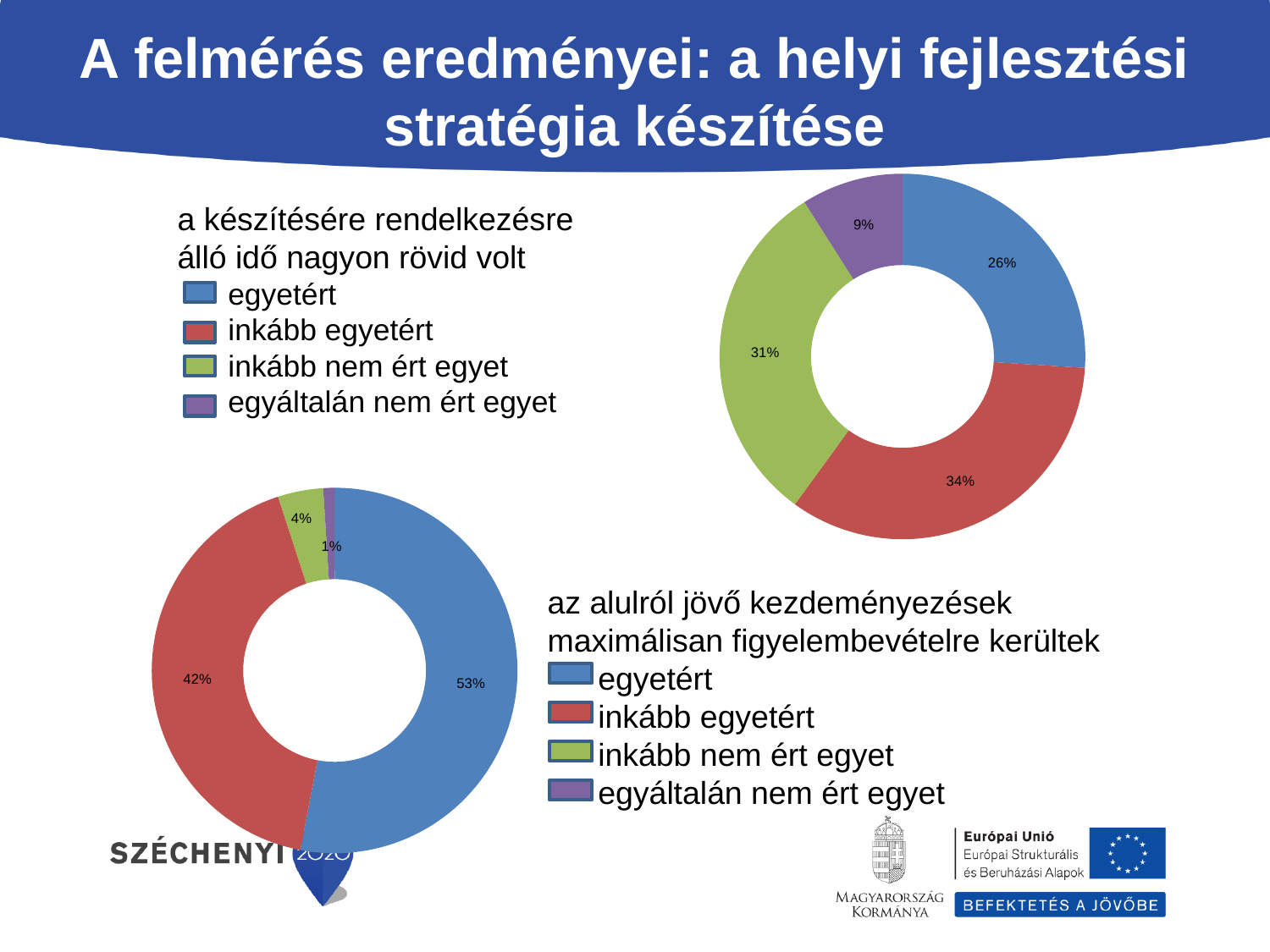
In the top-right chart (a készítésére rendelkezésre álló idő nagyon rövid volt), what share of respondents chose 'egyáltalán nem ért egyet'? 9% How many response categories does the legend of the top-right chart list? 4 In the top-right chart (a készítésére rendelkezésre álló idő nagyon rövid volt), what share of respondents chose 'inkább egyetért'? 34% What type of chart is used on this slide? Doughnut (pie) chart In the top-right chart (a készítésére rendelkezésre álló idő nagyon rövid volt), which response category has the smallest share? egyáltalán nem ért egyet In the bottom-left chart (az alulról jövő kezdeményezések maximálisan figyelembevételre kerültek), which is larger: 'egyetért' or 'inkább egyetért'? egyetért In the top-right chart (a készítésére rendelkezésre álló idő nagyon rövid volt), which response category has the largest share? inkább egyetért In the bottom-left chart (az alulról jövő kezdeményezések maximálisan figyelembevételre kerültek), what share of respondents chose 'inkább nem ért egyet'? 4% In the bottom-left chart (az alulról jövő kezdeményezések maximálisan figyelembevételre kerültek), what share of respondents chose 'egyetért'? 53% In the top-right chart (a készítésére rendelkezésre álló idő nagyon rövid volt), what is the difference in percentage points between 'inkább egyetért' and 'egyetért'? 8 percentage points In the bottom-left chart (az alulról jövő kezdeményezések maximálisan figyelembevételre kerültek), which response category has the smallest share? egyáltalán nem ért egyet In the bottom-left chart (az alulról jövő kezdeményezések maximálisan figyelembevételre kerültek), what is the combined share of 'egyetért' and 'inkább egyetért'? 95%